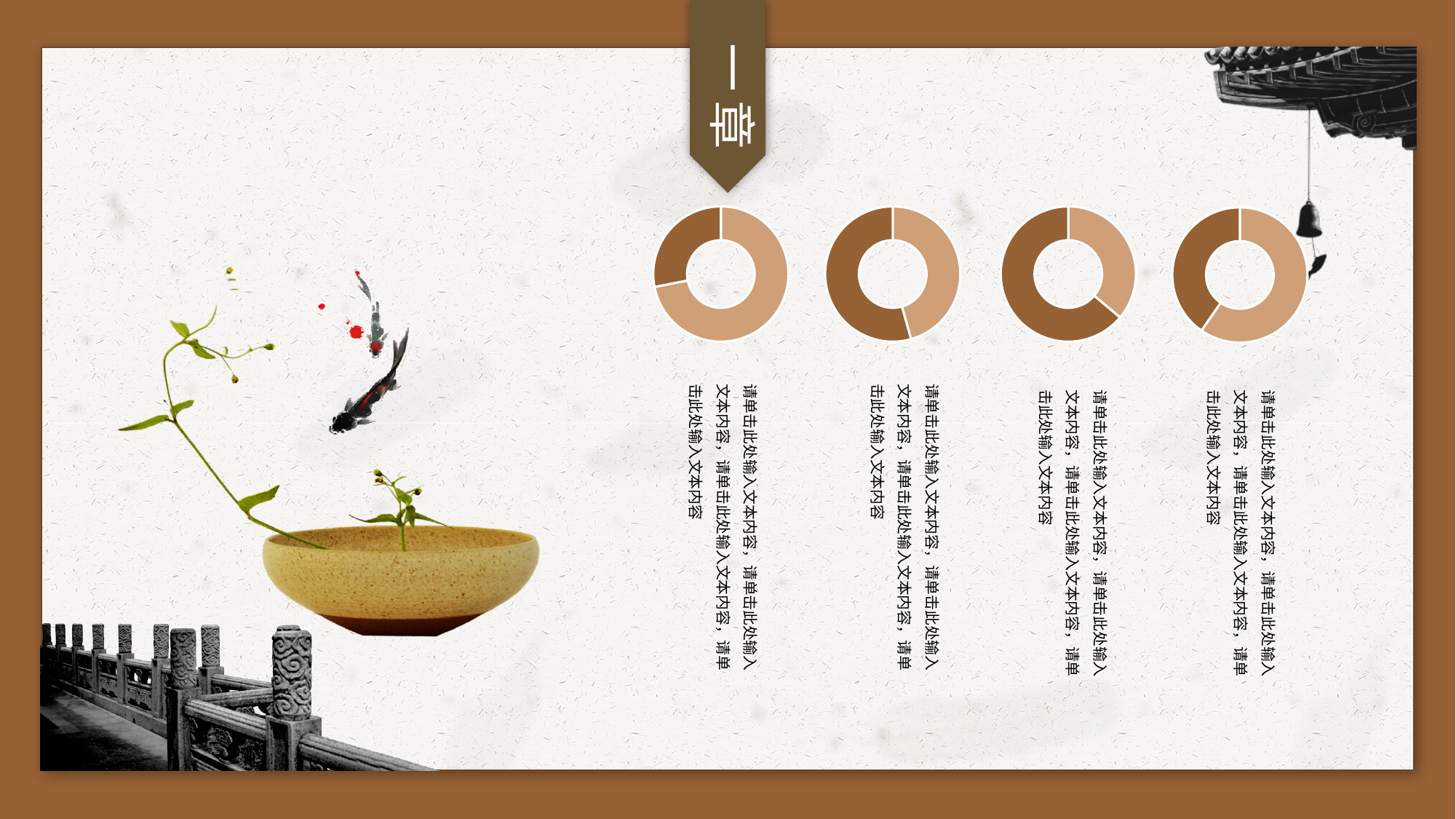
In the third doughnut chart from the left, which slice is larger, the dark brown one or the light tan one? the dark brown one Which of the four doughnut charts has the smallest dark brown slice? the leftmost chart How many colours are used for the slices in each doughnut chart? 2 What kind of chart is the leftmost chart on the slide? doughnut chart How many slices does the rightmost doughnut chart have? 2 Do the doughnut charts on the slide show any data labels with values? No In the rightmost doughnut chart, which slice is larger, the dark brown one or the light tan one? the light tan one In the second doughnut chart from the left, which slice is larger, the dark brown one or the light tan one? the dark brown one How many doughnut charts are shown on the slide? 4 How many slices does the leftmost doughnut chart have? 2